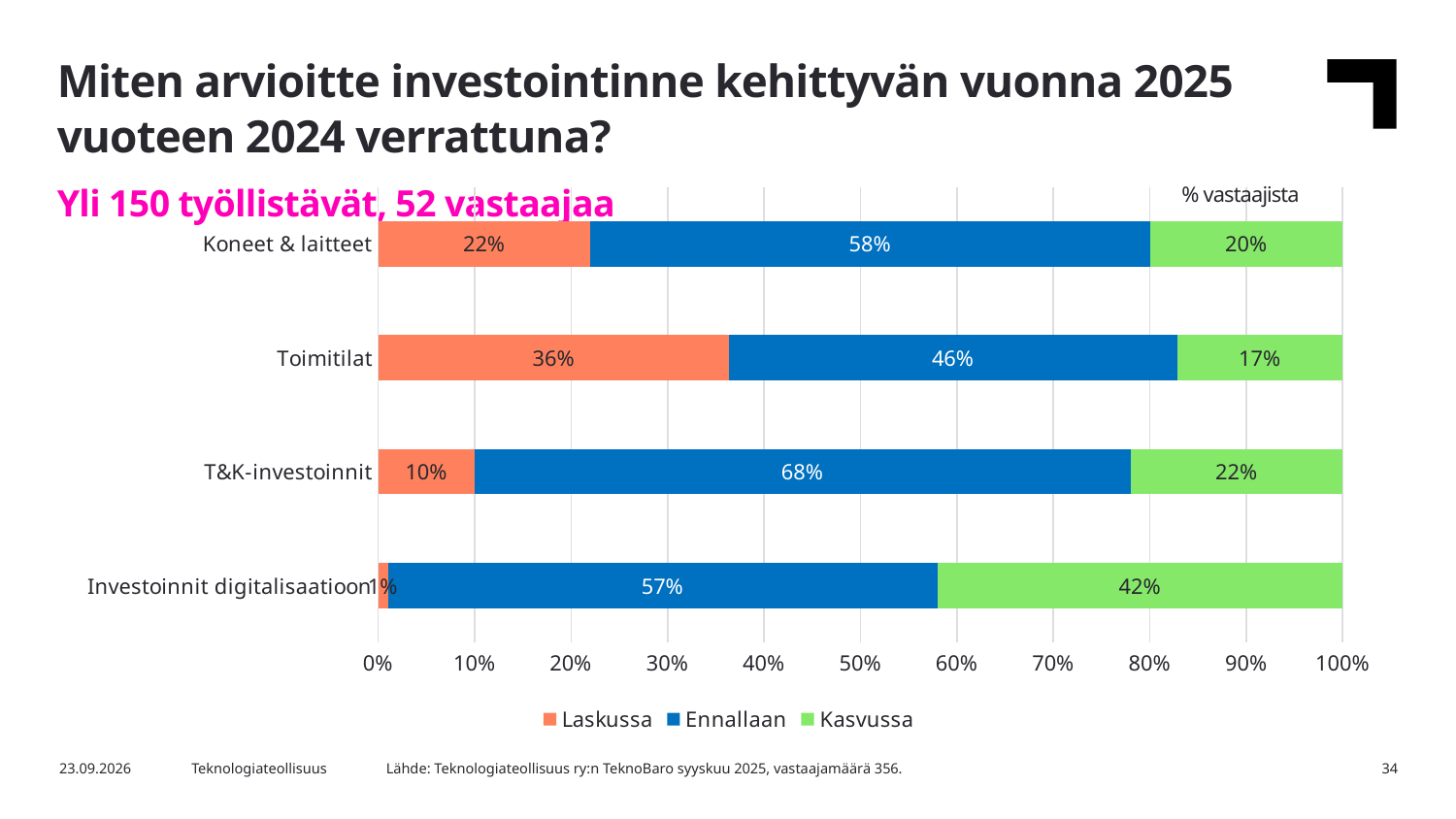
What type of chart is shown on the slide? Stacked bar chart Which category has the lowest Laskussa share? Investoinnit digitalisaatioon What is the Laskussa value for Toimitilat? 36% Which category has the highest Kasvussa share? Investoinnit digitalisaatioon What is the Kasvussa value for Investoinnit digitalisaatioon? 42% What is the difference between the Ennallaan values for T&K-investoinnit and Toimitilat? 22 percentage points How many series does the legend list? 3 What percentage of respondents said Koneet & laitteet investments are Ennallaan? 58% What is the Laskussa value for T&K-investoinnit? 10% Which is larger: the Laskussa value for Koneet & laitteet or the Laskussa value for Toimitilat? Toimitilat How many categories are shown on the chart? 4 Which category has the highest Ennallaan share? T&K-investoinnit